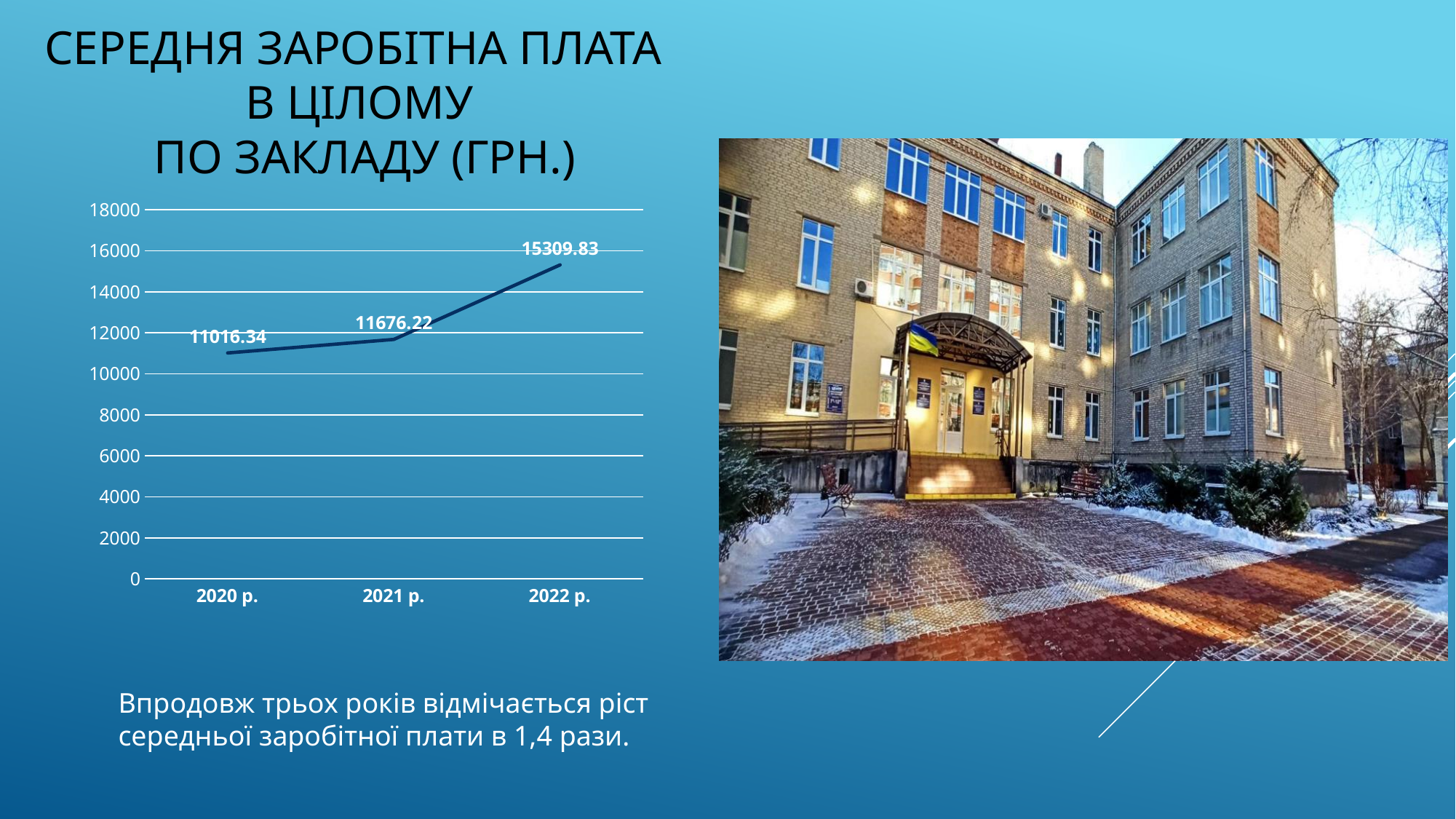
How many years (data points) are plotted on the chart? 3 Do the values rise or fall from 2020 р. to 2022 р.? rise Which is larger, the value for 2021 р. or the value for 2020 р.? 2021 р. Which year has the lowest average salary on the chart? 2020 р. Is the value for 2022 р. greater or less than 14000? greater Which year has the highest average salary on the chart? 2022 р. What is the average salary value shown for 2020 р.? 11016.34 What is the average salary value shown for 2022 р.? 15309.83 What is the average salary value shown for 2021 р.? 11676.22 What kind of chart is shown on the slide? line chart What is the difference between the values for 2022 р. and 2021 р.? 3633.61 What is the difference between the values for 2021 р. and 2020 р.? 659.88